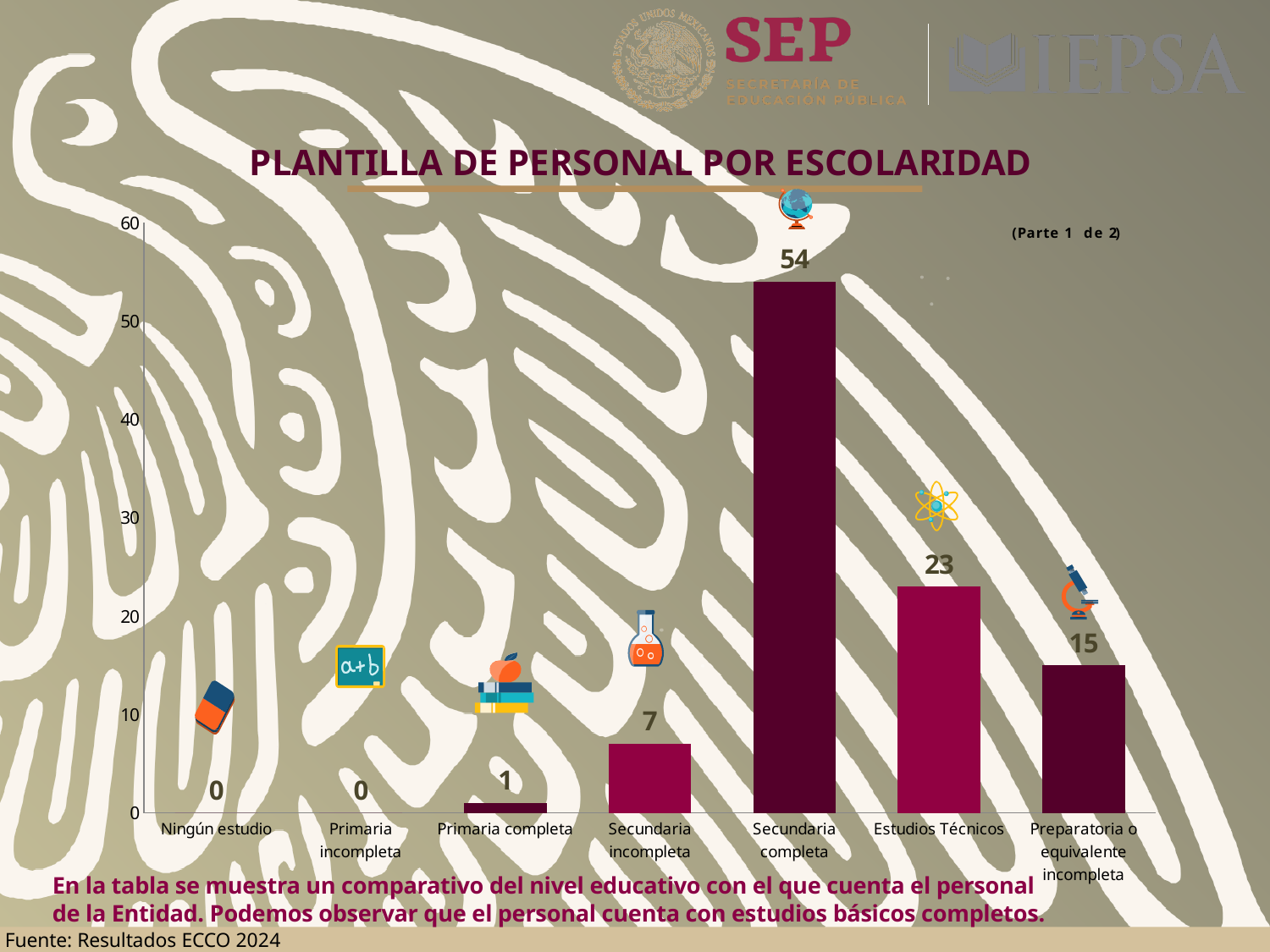
What is the value for Secundaria completa? 54 What is the value for Estudios Técnicos? 23 What is the title of the chart? PLANTILLA DE PERSONAL POR ESCOLARIDAD Is the value for Secundaria completa greater or less than 50? greater Which category has the highest value? Secundaria completa Which is larger, Estudios Técnicos or Preparatoria o equivalente incompleta? Estudios Técnicos What is the difference between Secundaria completa and Estudios Técnicos? 31 What kind of chart is shown on the slide? bar chart How many categories are shown on the x axis? 7 What is the value for Secundaria incompleta? 7 What is the value for Preparatoria o equivalente incompleta? 15 What is the value for Primaria completa? 1